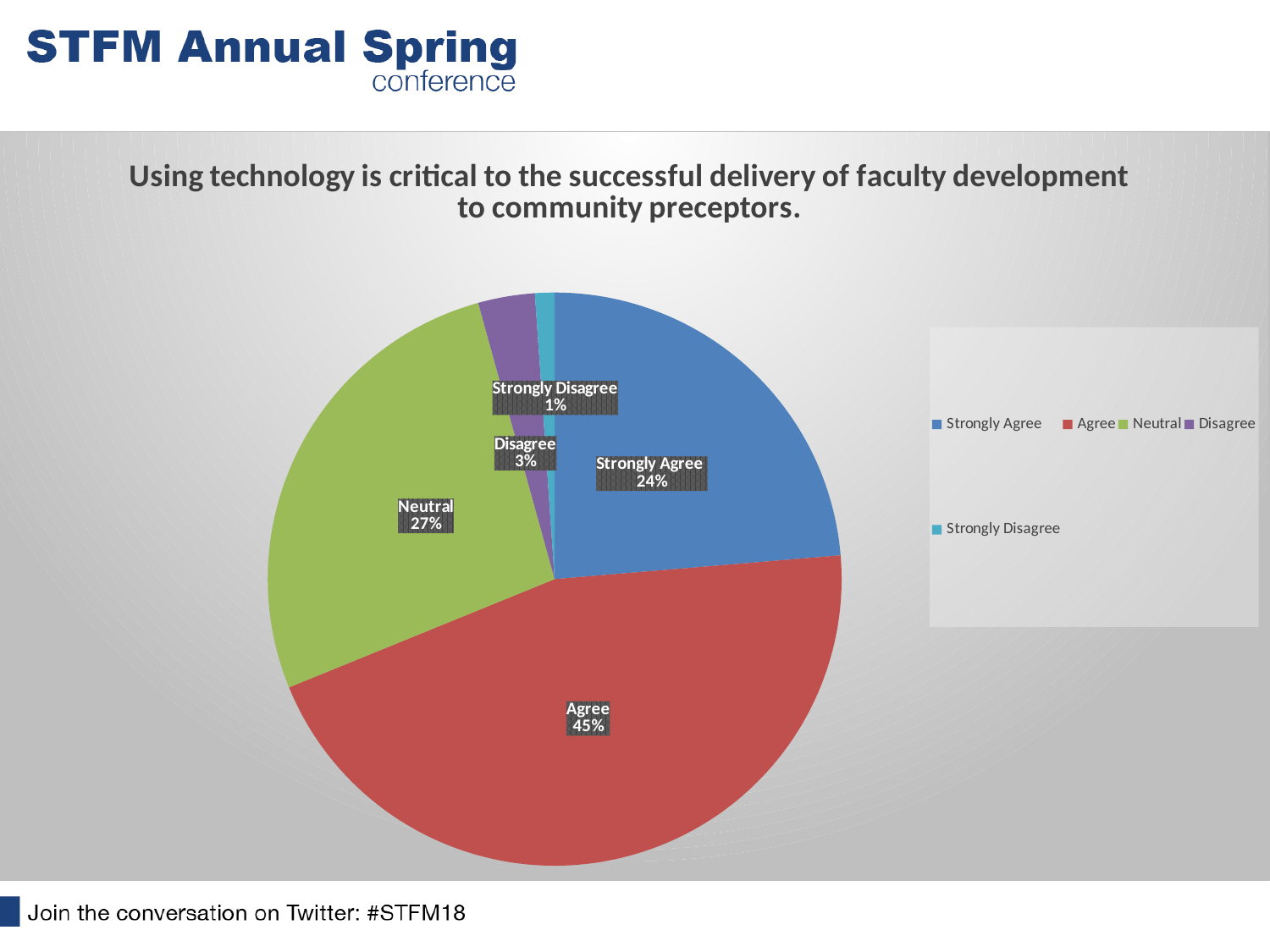
What percentage of respondents chose Disagree? 3% Which response category has the largest share of the pie? Agree What is the difference in percentage points between Agree and Strongly Agree? 21 What is the title of the chart? Using technology is critical to the successful delivery of faculty development to community preceptors. Which response category has the smallest share of the pie? Strongly Disagree What percentage of respondents chose Strongly Agree? 24% What percentage of respondents chose Neutral? 27% What kind of chart is shown on the slide? pie chart What percentage of respondents chose Agree? 45% Which is larger, the Neutral slice or the Strongly Agree slice? Neutral How many response categories are shown in the pie chart? 5 What percentage of respondents chose Strongly Disagree? 1%